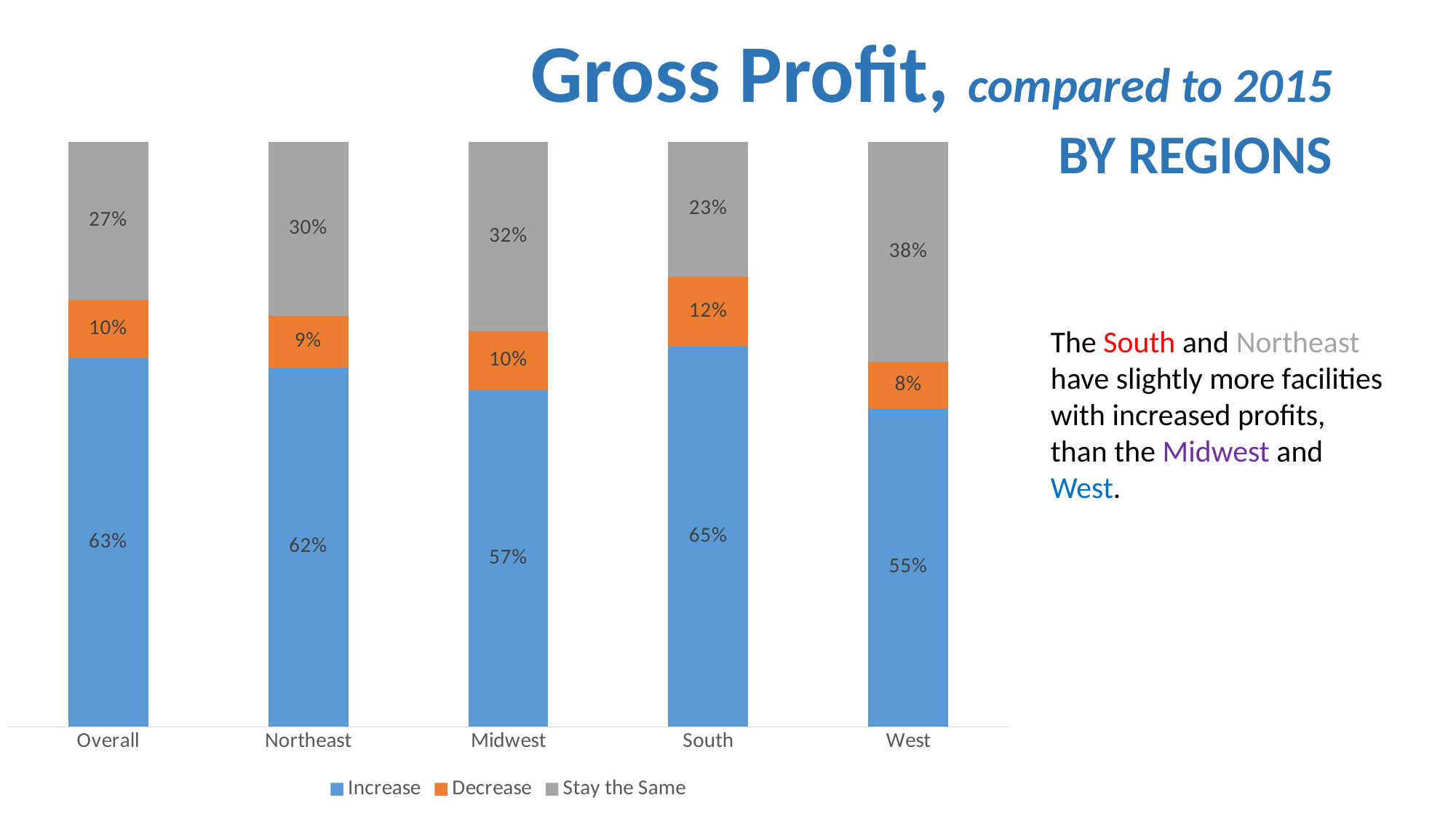
Which has a larger Decrease value, the South or the West? South What is the Increase value for Overall? 63% Which category has the lowest Stay the Same percentage? South What kind of chart is shown on the slide? Stacked bar chart What is the Stay the Same value for the West? 38% Which region has the highest Increase percentage? South What percentage of facilities in the South reported an Increase in gross profit? 65% What is the Decrease value for the Northeast? 9% What is the difference between the Increase values for the South and the West? 10% How many series does the legend list? 3 How many categories are shown on the x axis? 5 Which colour represents the Decrease series? Orange